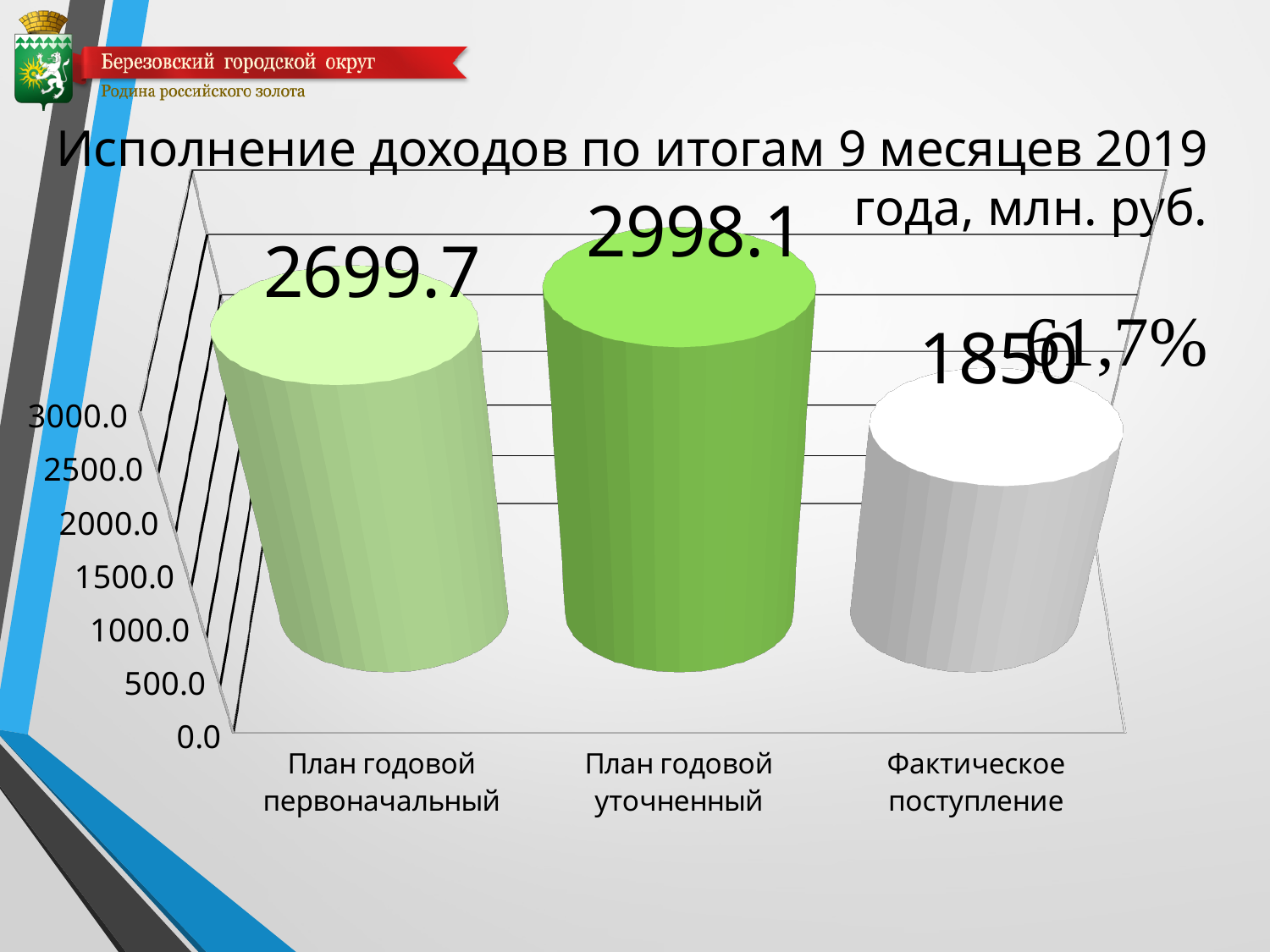
What is the title of the chart? Исполнение доходов по итогам 9 месяцев 2019 года, млн. руб. Is the value for «Фактическое поступление» greater or less than 2000? less Which is larger: «План годовой первоначальный» or «План годовой уточненный»? План годовой уточненный What is the value for «План годовой первоначальный»? 2699.7 What kind of chart is shown on the slide? bar chart What is the difference between «План годовой уточненный» and «План годовой первоначальный»? 298.4 What is the value for «План годовой уточненный»? 2998.1 In what units are the values on the chart given, according to the title? млн. руб. Which category has the lowest value? Фактическое поступление How many categories are shown on the chart? 3 Which category has the highest value? План годовой уточненный Is the value for «План годовой уточненный» greater or less than 2500? greater